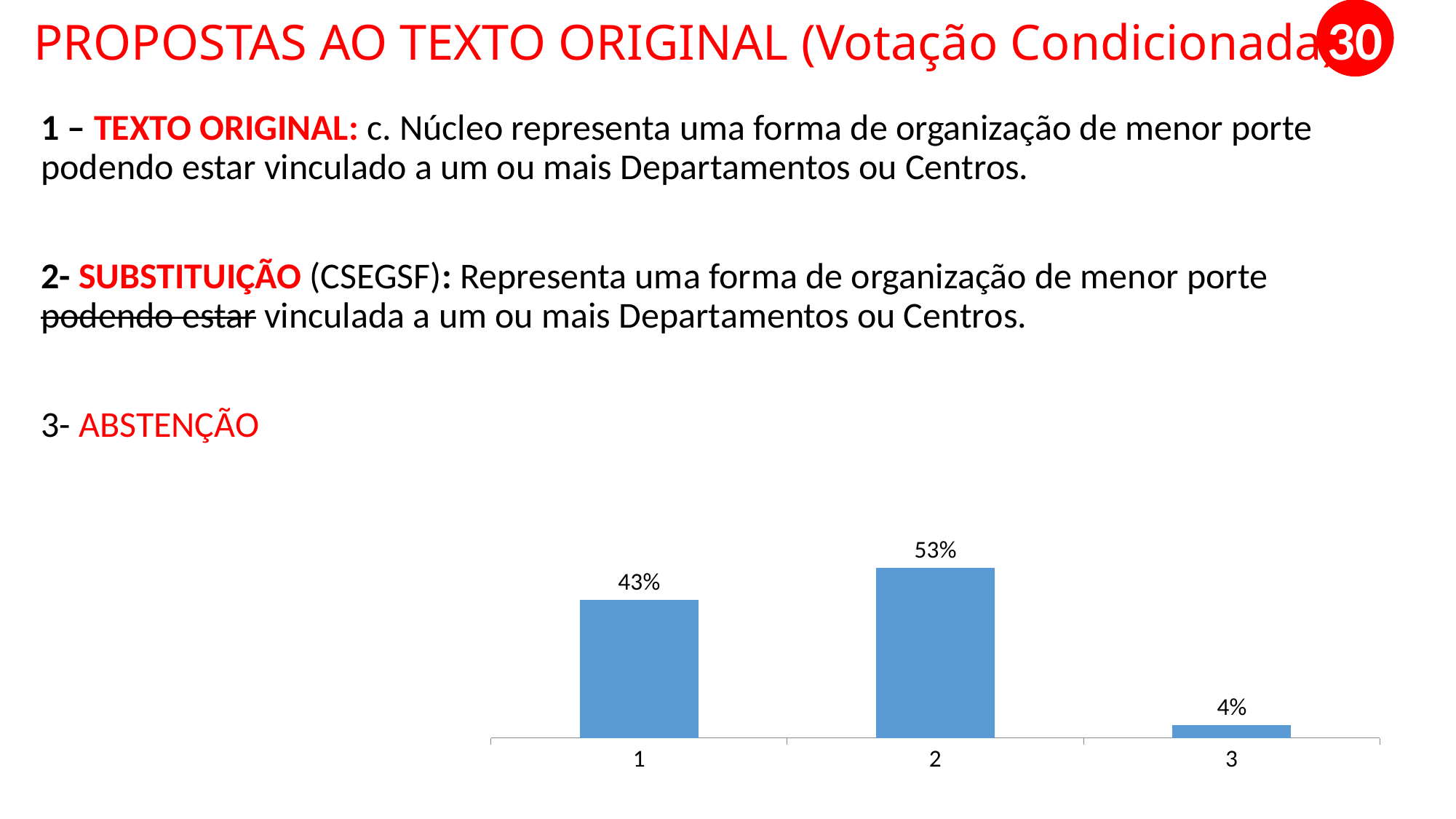
What is the difference between the values for category 1 and category 3? 39% Does the chart have a legend? No What kind of chart is shown on the slide? bar chart Which category has the lowest value? 3 What is the value for category 2? 53% Which is larger, the value for category 1 or category 2? 2 What is the value for category 1? 43% What colour are the bars in the chart? blue What is the difference between the values for category 2 and category 1? 10% How many categories are shown on the x axis? 3 What is the value for category 3? 4% Which category has the highest value? 2